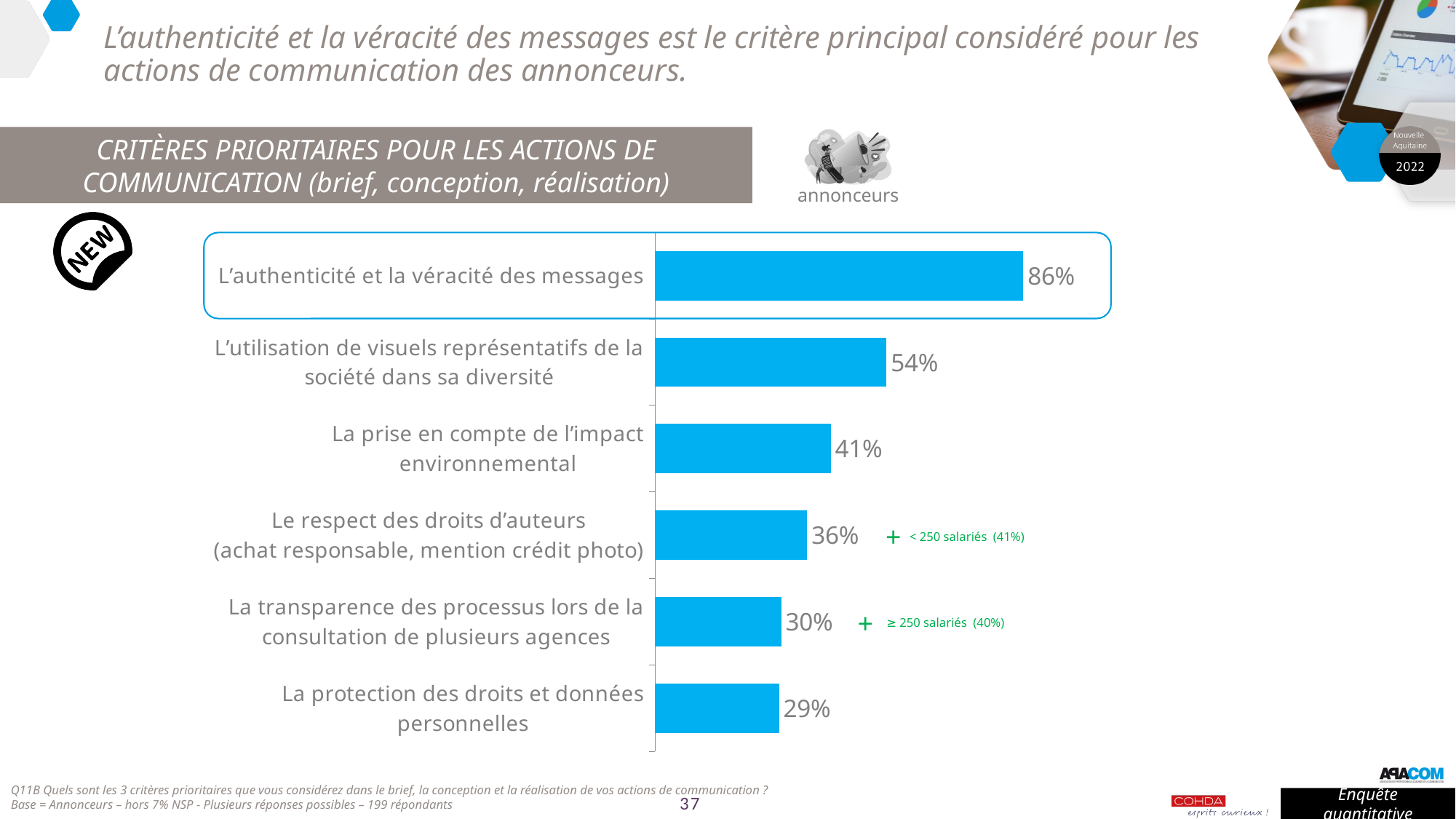
What type of chart is shown on the slide? Bar chart What is the difference between 'L'authenticité et la véracité des messages' and 'L'utilisation de visuels représentatifs de la société dans sa diversité'? 32 percentage points What is the value for 'L'utilisation de visuels représentatifs de la société dans sa diversité'? 54% What is the title of the chart? CRITÈRES PRIORITAIRES POUR LES ACTIONS DE COMMUNICATION (brief, conception, réalisation) Which criterion has the highest percentage? L'authenticité et la véracité des messages What is the difference between 'Le respect des droits d'auteurs' and 'La protection des droits et données personnelles'? 7 percentage points What percentage of advertisers cite 'L'authenticité et la véracité des messages' as a priority criterion? 86% Which is larger: 'Le respect des droits d'auteurs' or 'La transparence des processus lors de la consultation de plusieurs agences'? Le respect des droits d'auteurs How many criteria are shown in the chart? 6 Which criterion has the lowest percentage? La protection des droits et données personnelles What is the value for 'La protection des droits et données personnelles'? 29% What is the value for 'La prise en compte de l'impact environnemental'? 41%